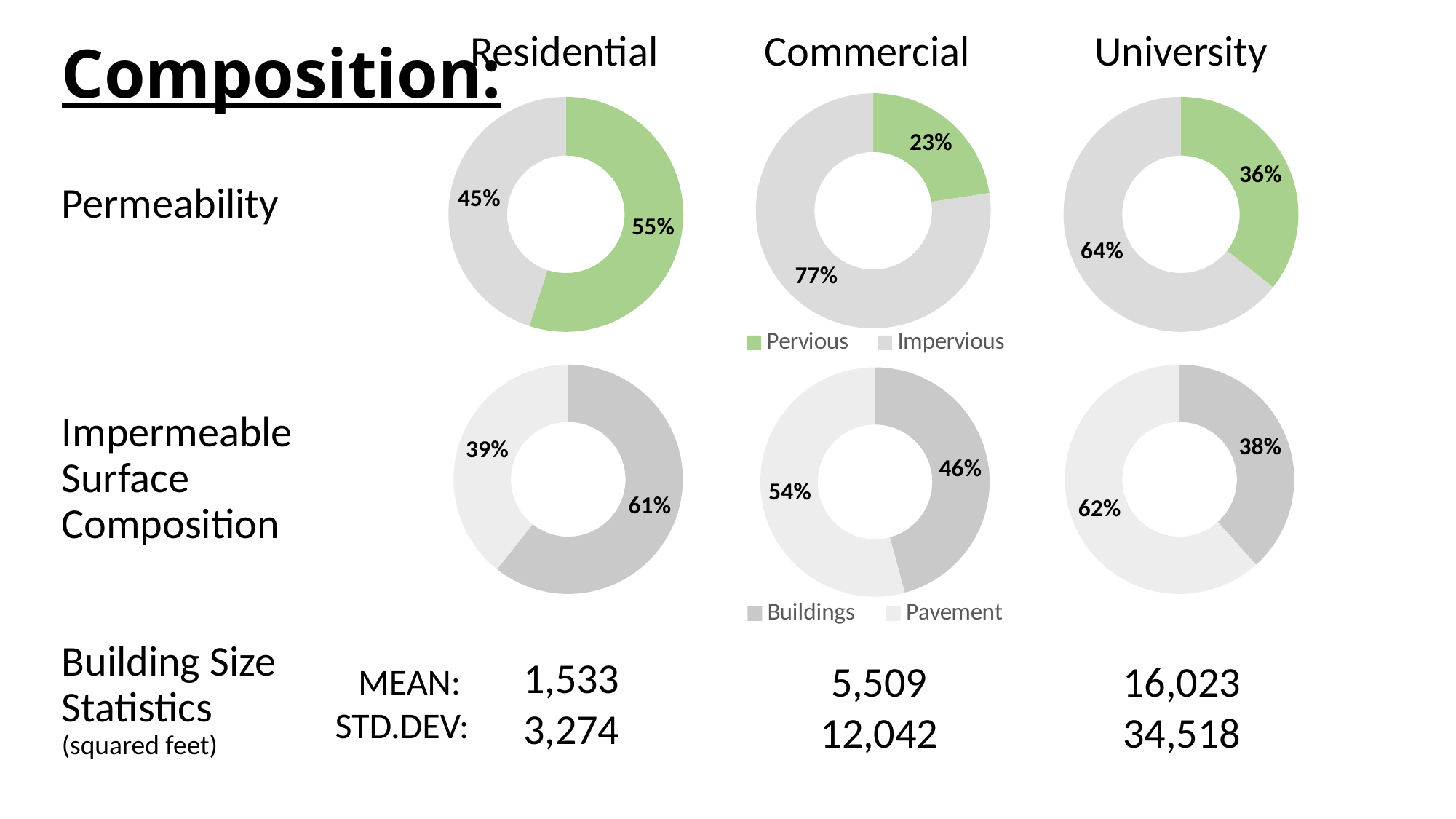
In the Commercial Permeability donut chart, what is the difference between the Impervious and Pervious shares? 54% How many series does the legend for the Impermeable Surface Composition charts list? 2 In the Residential Impermeable Surface Composition donut chart, what share is Buildings? 61% Across the three Permeability donut charts, which land use has the lowest Pervious share? Commercial In the University Permeability donut chart, what share is Pervious? 36% In the Commercial Impermeable Surface Composition donut chart, which is larger, Buildings or Pavement? Pavement What kind of chart is used in the Permeability row? Donut (pie) chart In the University Impermeable Surface Composition donut chart, what share is Buildings? 38% Across the three Permeability donut charts, which land use has the highest Pervious share? Residential In the Commercial Impermeable Surface Composition donut chart, what share is Pavement? 54% In the Commercial Permeability donut chart, what share is Impervious? 77% In the Residential Permeability donut chart, what share is Pervious? 55%